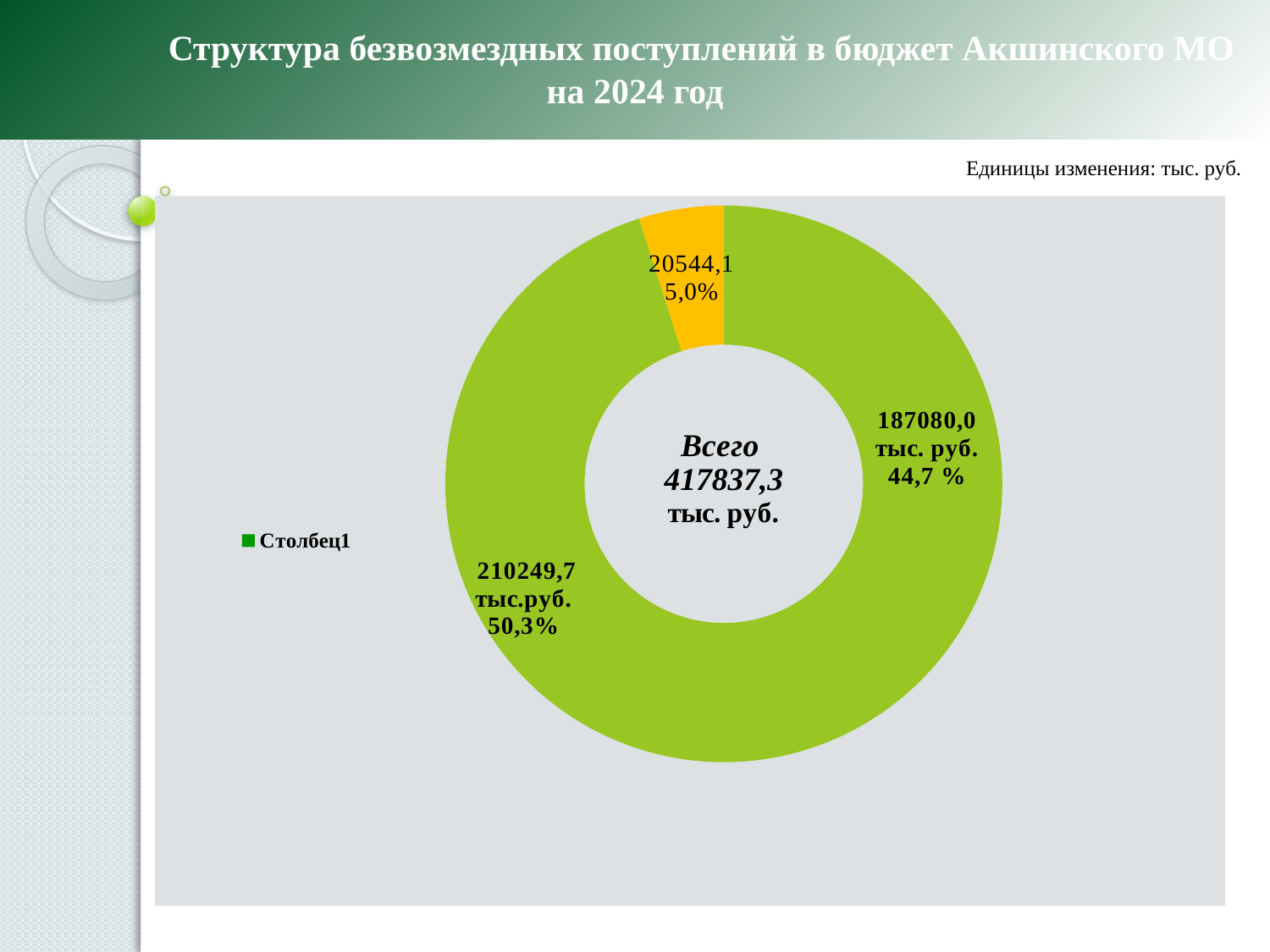
What percentage share is shown for the slice labelled 210249,7 тыс.руб.? 50,3% Which slice has the larger share: the one with 50,3% or the one with 44,7 %? the one with 50,3% What percentage share is shown for the slice labelled 187080,0 тыс. руб.? 44,7 % How many slices does the doughnut chart have? 3 What total value is printed in the centre of the doughnut chart? 417837,3 тыс. руб. What entry does the legend of the chart list? Столбец1 What units of measurement are stated above the chart? тыс. руб. What kind of chart is shown on the slide? doughnut chart What is the value of the largest slice in the doughnut chart? 210249,7 тыс.руб. What is the value of the smallest slice in the doughnut chart? 20544,1 What is the difference between the slice valued 210249,7 and the slice valued 187080,0? 23169,7 What percentage share is shown for the orange slice of the doughnut chart? 5,0%